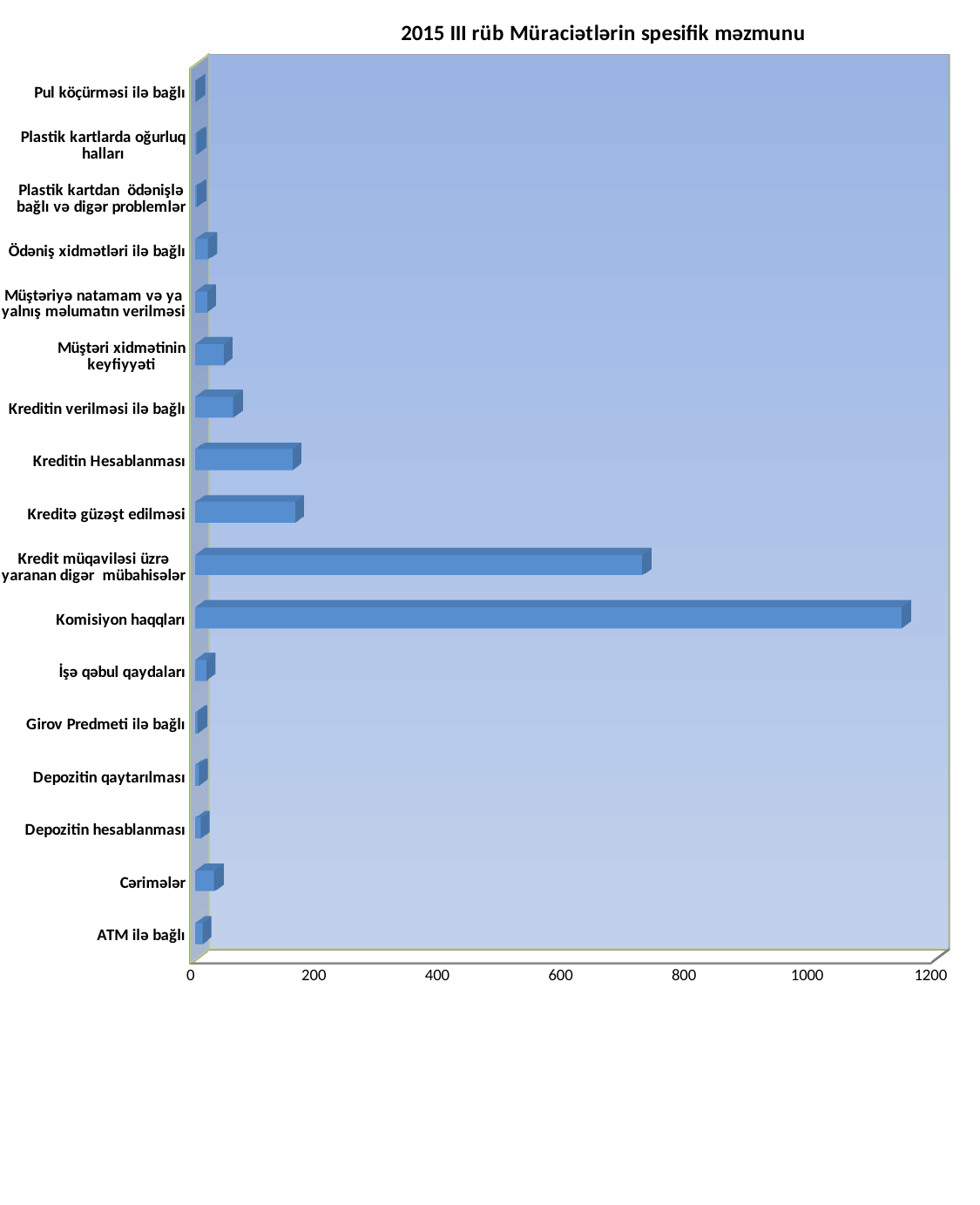
What kind of chart is shown on the slide? bar chart Is the value for Kredit müqaviləsi üzrə yaranan digər mübahisələr greater or less than 600? greater Which is larger, the value for Kreditin Hesablanması or the value for Kreditin verilməsi ilə bağlı? Kreditin Hesablanması How many categories are plotted in the chart? 17 Is the value for Kreditin verilməsi ilə bağlı greater or less than 200? less Is the value for Kredit müqaviləsi üzrə yaranan digər mübahisələr greater or less than 800? less What is the title of the chart? 2015 III rüb Müraciətlərin spesifik məzmunu Which category has the highest value? Komisiyon haqqları Which is larger, the value for Komisiyon haqqları or the value for Kredit müqaviləsi üzrə yaranan digər mübahisələr? Komisiyon haqqları What is the highest value shown on the horizontal axis? 1200